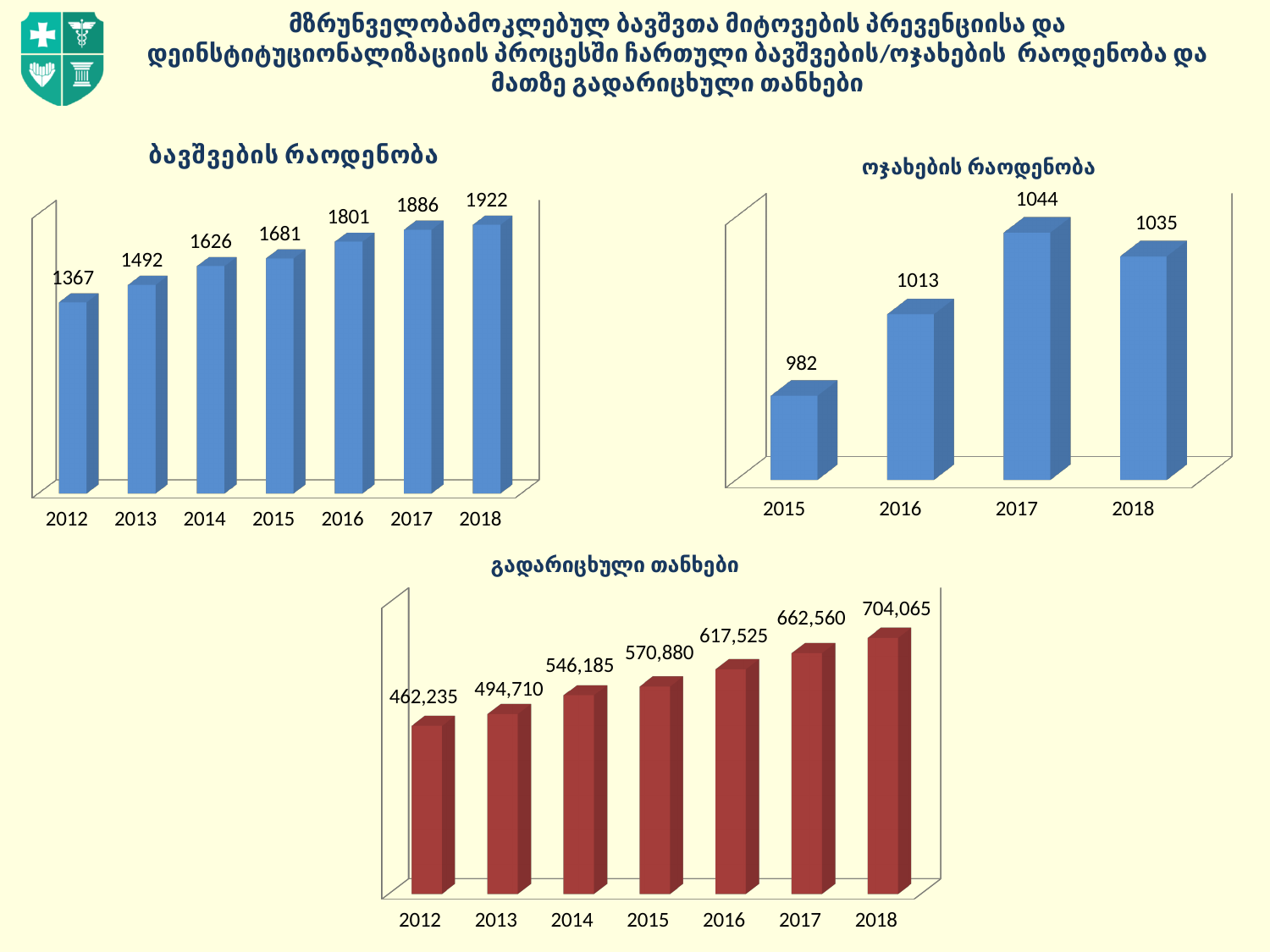
In the top-left chart (ბავშვების რაოდენობა), what is the difference between the 2018 and 2012 values? 555 In the top-right chart (ოჯახების რაოდენობა), what is the value for 2016? 1013 In the bottom chart (გადარიცხული თანხები), do the values rise or fall from 2012 to 2018? rise In the top-left chart (ბავშვების რაოდენობა), how many years are shown on the x axis? 7 In the top-right chart (ოჯახების რაოდენობა), how many bars are there? 4 In the top-right chart (ოჯახების რაოდენობა), which is larger, the value for 2017 or the value for 2018? 2017 In the top-left chart (ბავშვების რაოდენობა), which year has the highest value? 2018 In the top-right chart (ოჯახების რაოდენობა), which year has the lowest value? 2015 What type of chart is the bottom chart (გადარიცხული თანხები)? bar chart In the top-left chart (ბავშვების რაოდენობა), what is the value for 2014? 1626 In the bottom chart (გადარიცხული თანხები), what is the value for 2015? 570,880 In the bottom chart (გადარიცხული თანხები), what is the difference between the 2017 and 2016 values? 45,035